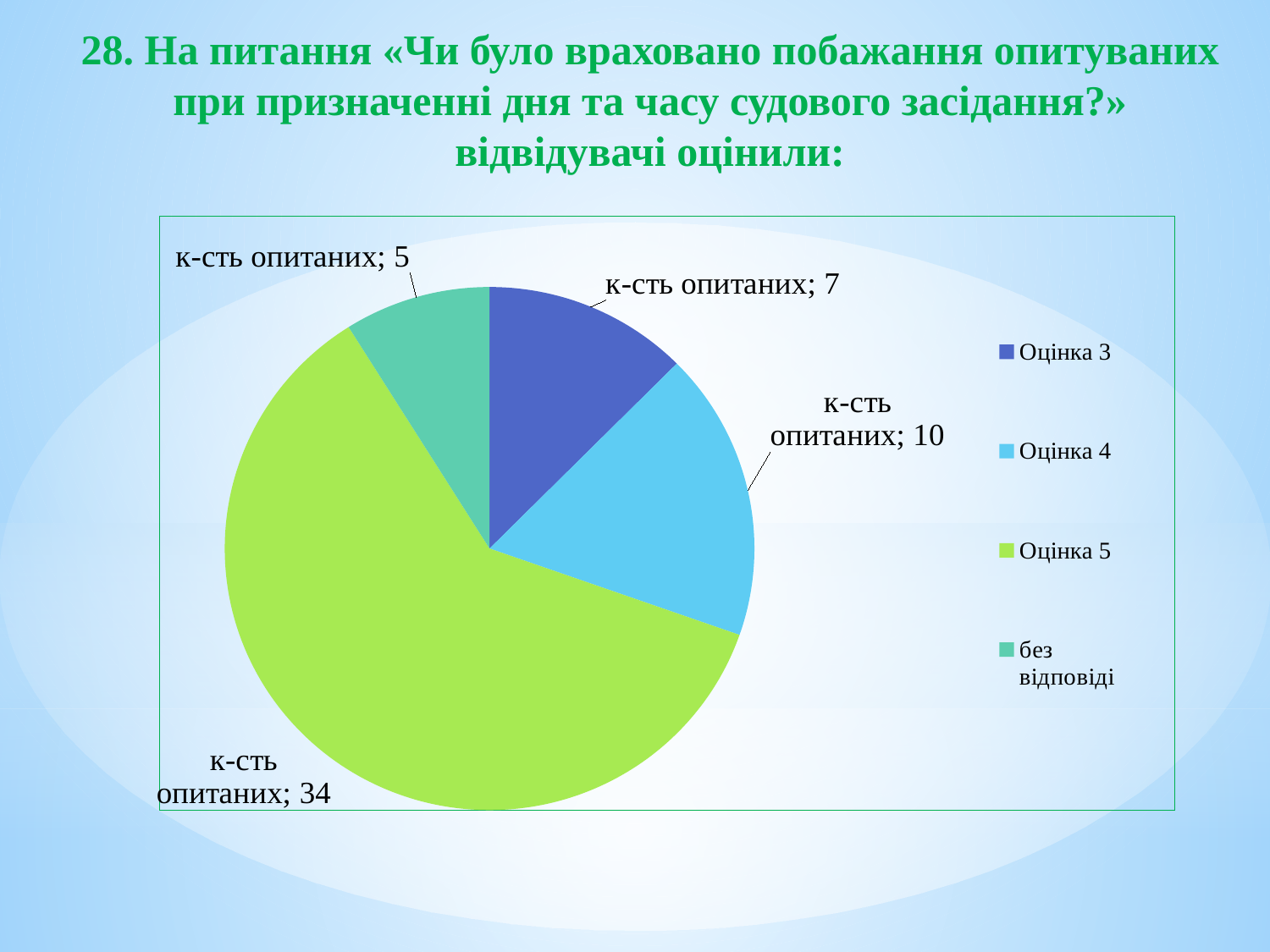
How many slices does the pie chart have? 4 What colour is the slice for Оцінка 5? green Which category has the largest slice? Оцінка 5 What is the value for без відповіді? 5 What kind of chart is shown on the slide? pie chart Which category has the smallest slice? без відповіді What is the total of all slices in the pie chart? 56 What is the value for Оцінка 5? 34 What is the value for Оцінка 4? 10 What is the difference between the values for Оцінка 5 and Оцінка 4? 24 What is the value for Оцінка 3? 7 Which is larger, the value for Оцінка 3 or the value for без відповіді? Оцінка 3